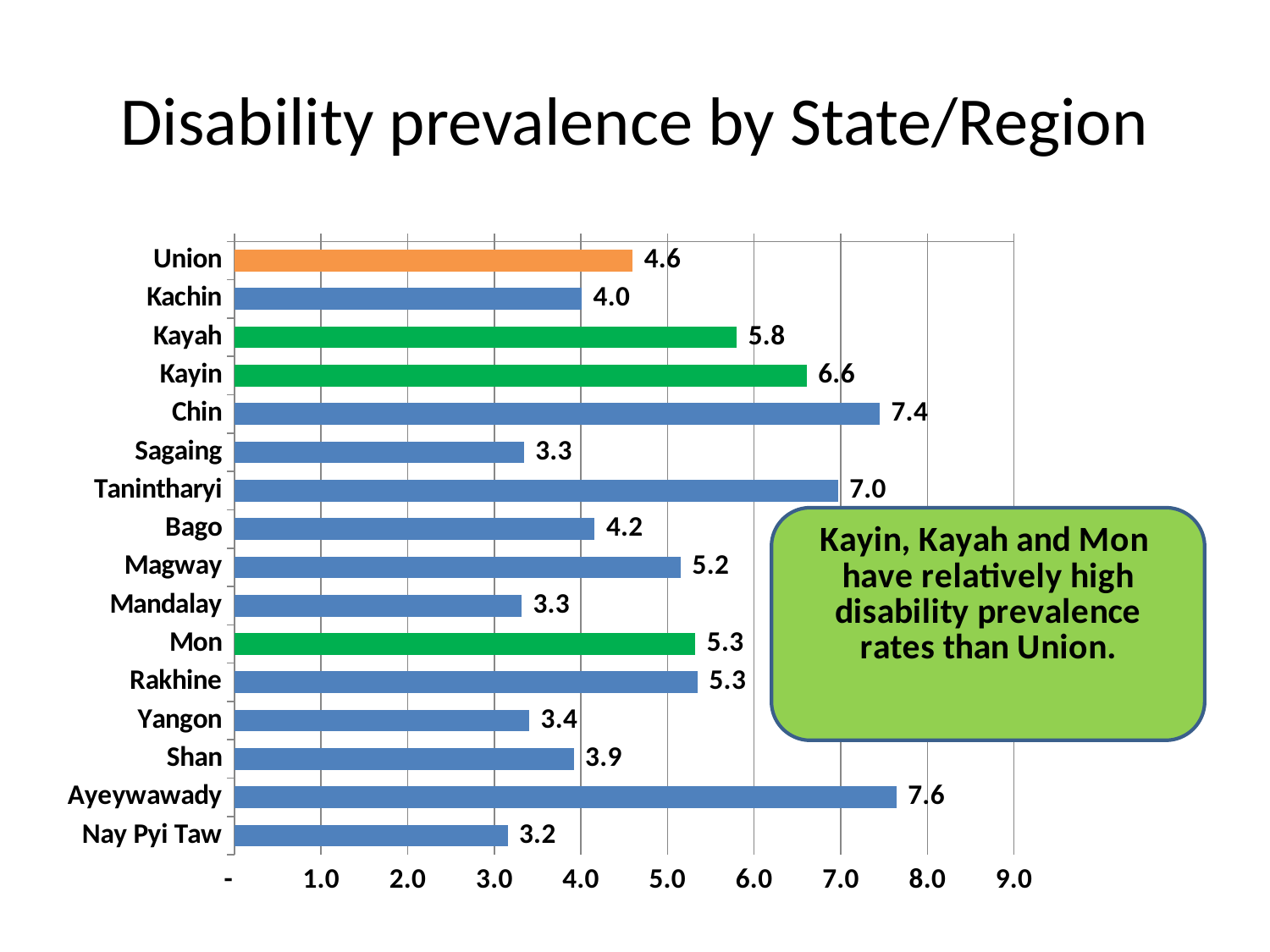
What is the title of the slide? Disability prevalence by State/Region What is the disability prevalence value for Kayin? 6.6 Which three States/Regions are highlighted with green bars? Kayah, Kayin and Mon What is the disability prevalence value for Chin? 7.4 Which State/Region has the highest disability prevalence? Ayeywawady Which State/Region has the lowest disability prevalence? Nay Pyi Taw Which has a higher disability prevalence, Tanintharyi or Magway? Tanintharyi Is the value for Ayeywawady greater or less than 7.0? greater What is the disability prevalence value for Union? 4.6 How many State/Region categories (including Union) are shown in the chart? 16 What kind of chart is shown on the slide? Bar chart What is the difference between the disability prevalence of Kayin and Union? 2.0